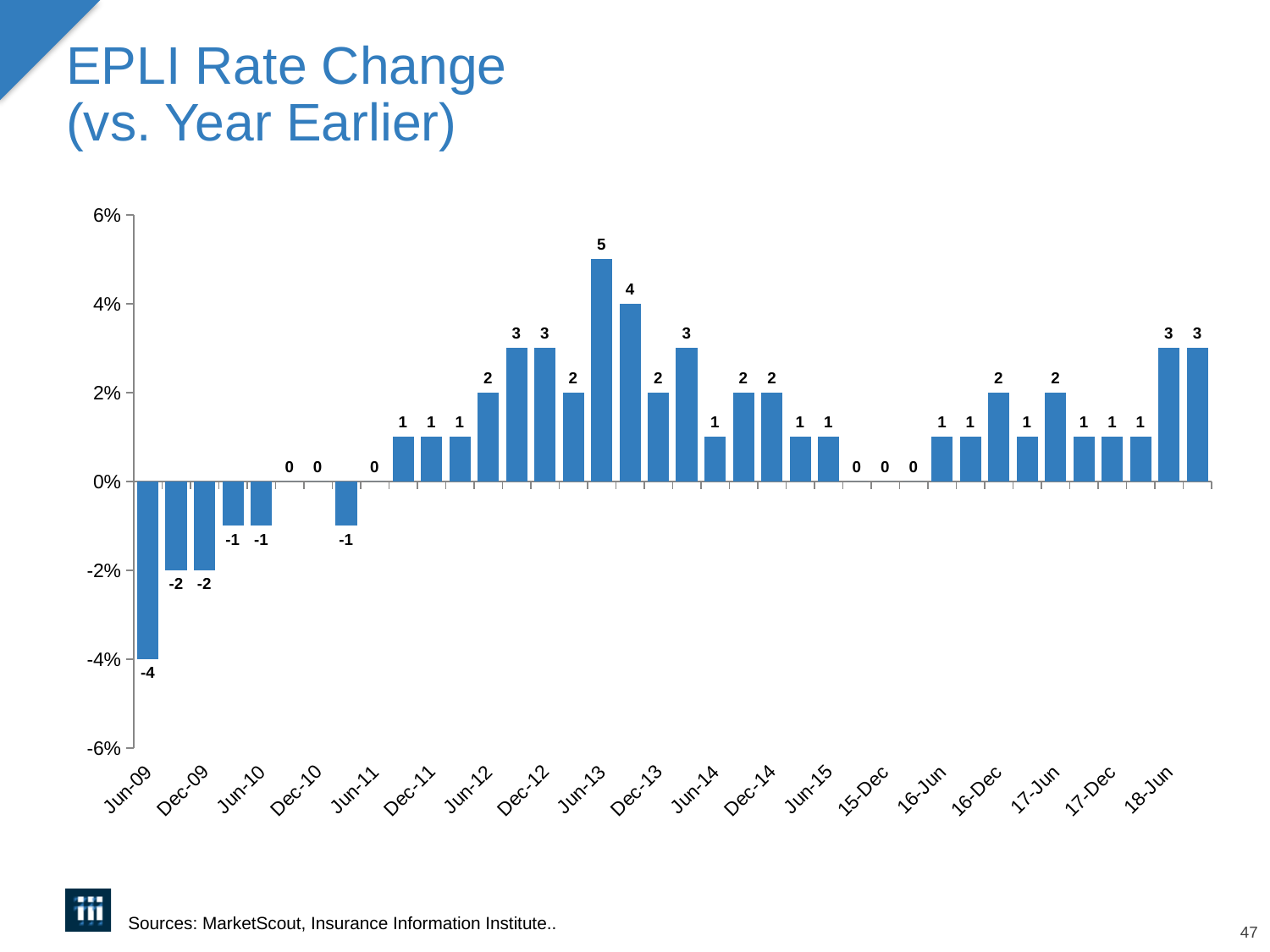
What is the EPLI rate change value for 18-Jun? 3 What is the EPLI rate change value for Jun-09? -4 Do the values generally rise or fall from Jun-09 to Jun-13? rise Which labeled period has the lowest EPLI rate change? Jun-09 What is the EPLI rate change value for Jun-13? 5 What type of chart is shown on the slide? bar chart What is the title of the chart? EPLI Rate Change (vs. Year Earlier) What is the EPLI rate change value for Dec-12? 3 What is the difference between the values for Jun-13 and Jun-09? 9 How many bars are plotted in the chart? 38 Which labeled period has the highest EPLI rate change? Jun-13 Which is larger, the value for Jun-13 or the value for Dec-13? Jun-13